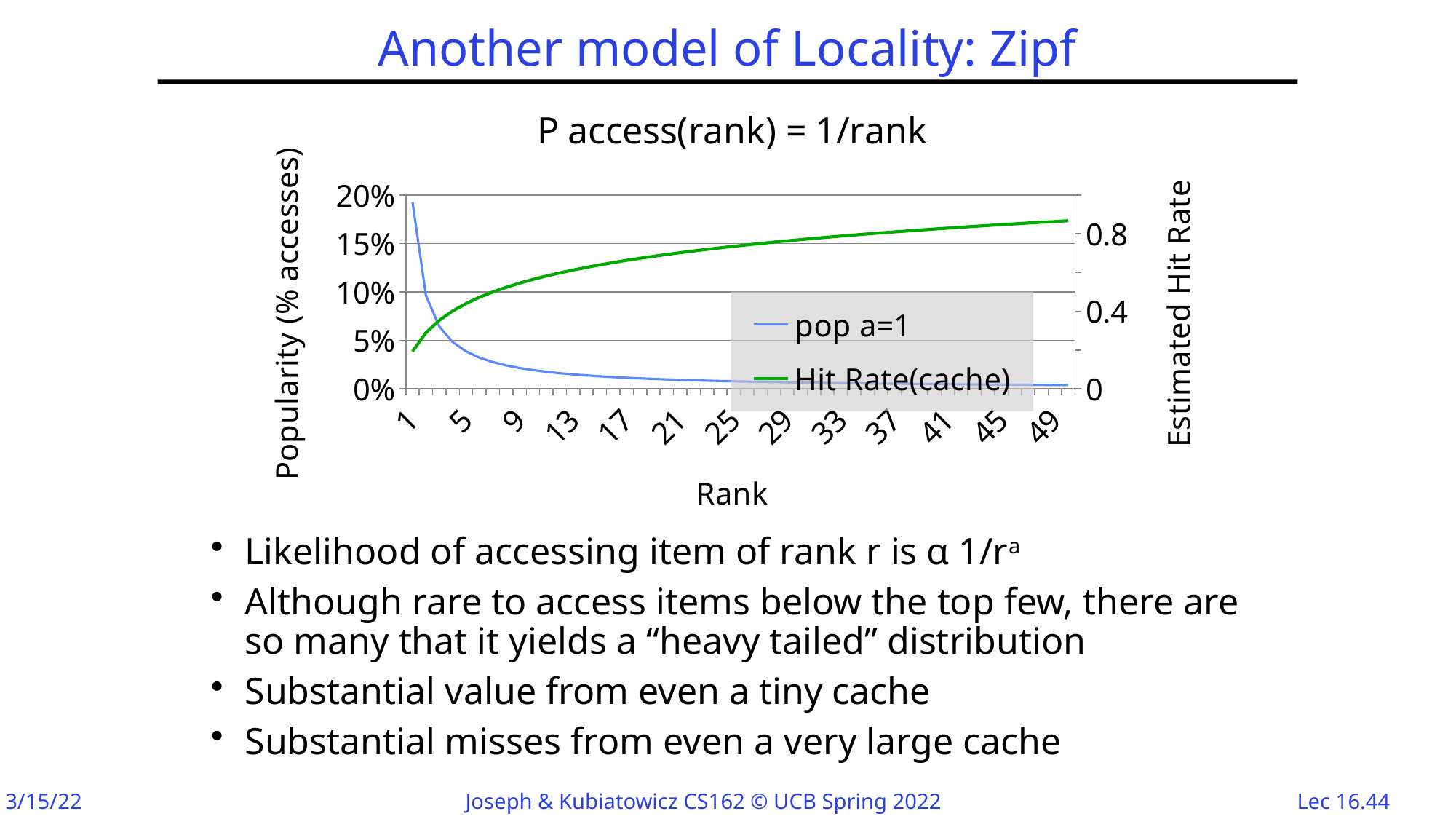
What is the label of the x axis? Rank Does the 'pop a=1' series rise or fall as rank increases? fall Which series is plotted in green? Hit Rate(cache) What kind of chart is shown on the slide? line chart Is the value of 'pop a=1' at rank 9 greater or less than 5%? less Does the 'Hit Rate(cache)' series rise or fall as rank increases? rise Is the value of 'pop a=1' at rank 1 greater or less than 15%? greater Is the value of 'Hit Rate(cache)' at rank 49 greater or less than 0.8? greater How many series does the legend list? 2 What is the title of the chart? P access(rank) = 1/rank